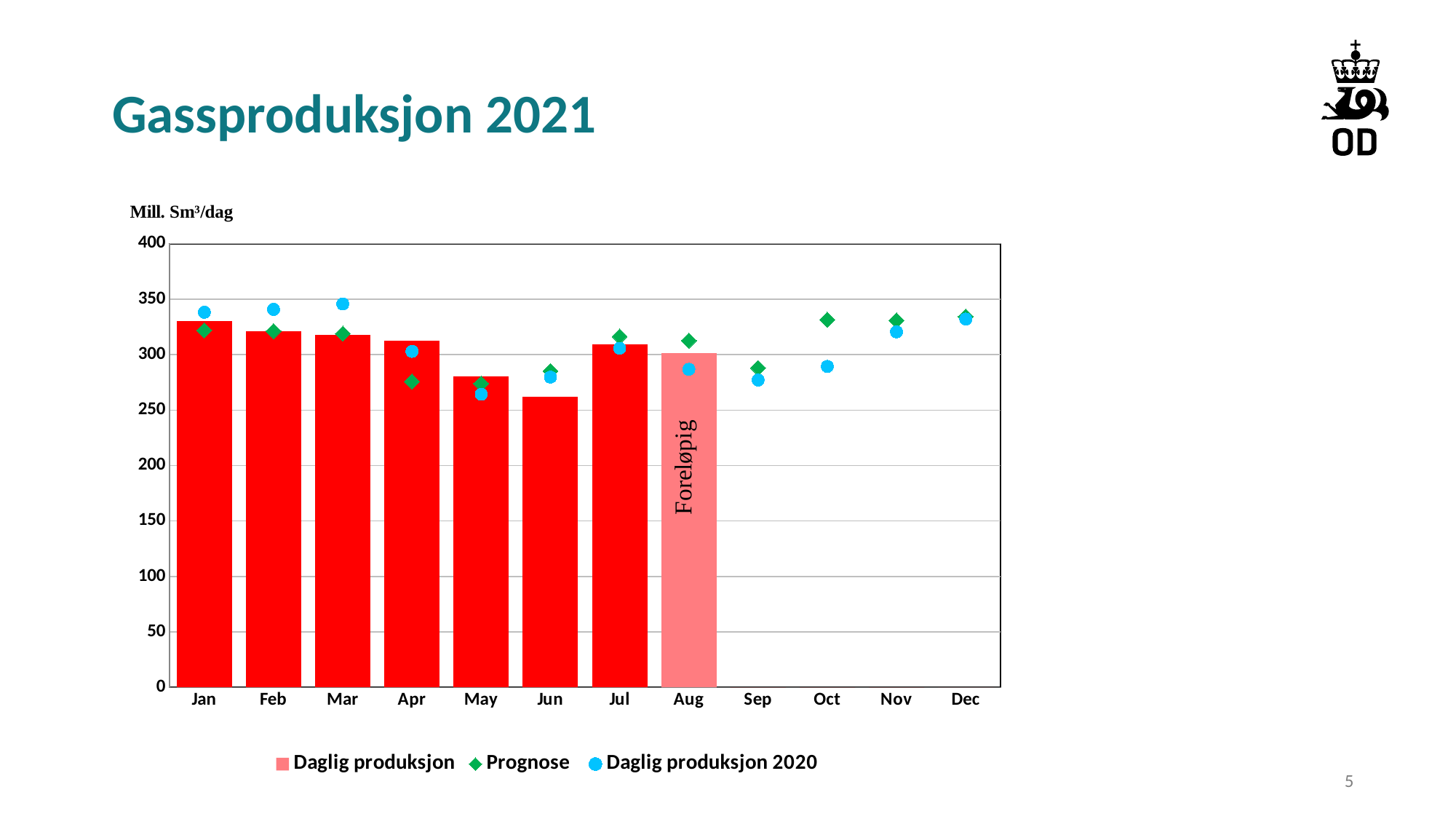
Do the Daglig produksjon bars rise or fall from Jan to Jun? fall Is the Daglig produksjon value for Jan greater or less than 300? greater In Mar, which is higher: the Daglig produksjon bar or the Daglig produksjon 2020 marker? Daglig produksjon 2020 Is the Prognose value for Oct greater or less than 300? greater Is the Daglig produksjon value for Jun greater or less than 300? less For how many months is a Daglig produksjon bar plotted? 8 Which month has the lowest Daglig produksjon bar? Jun What label is written on the Aug bar? Foreløpig Which month has the highest Daglig produksjon bar? Jan How many series does the legend list? 3 What kind of chart is shown on the slide? Bar chart with point markers How many months are shown on the x axis? 12